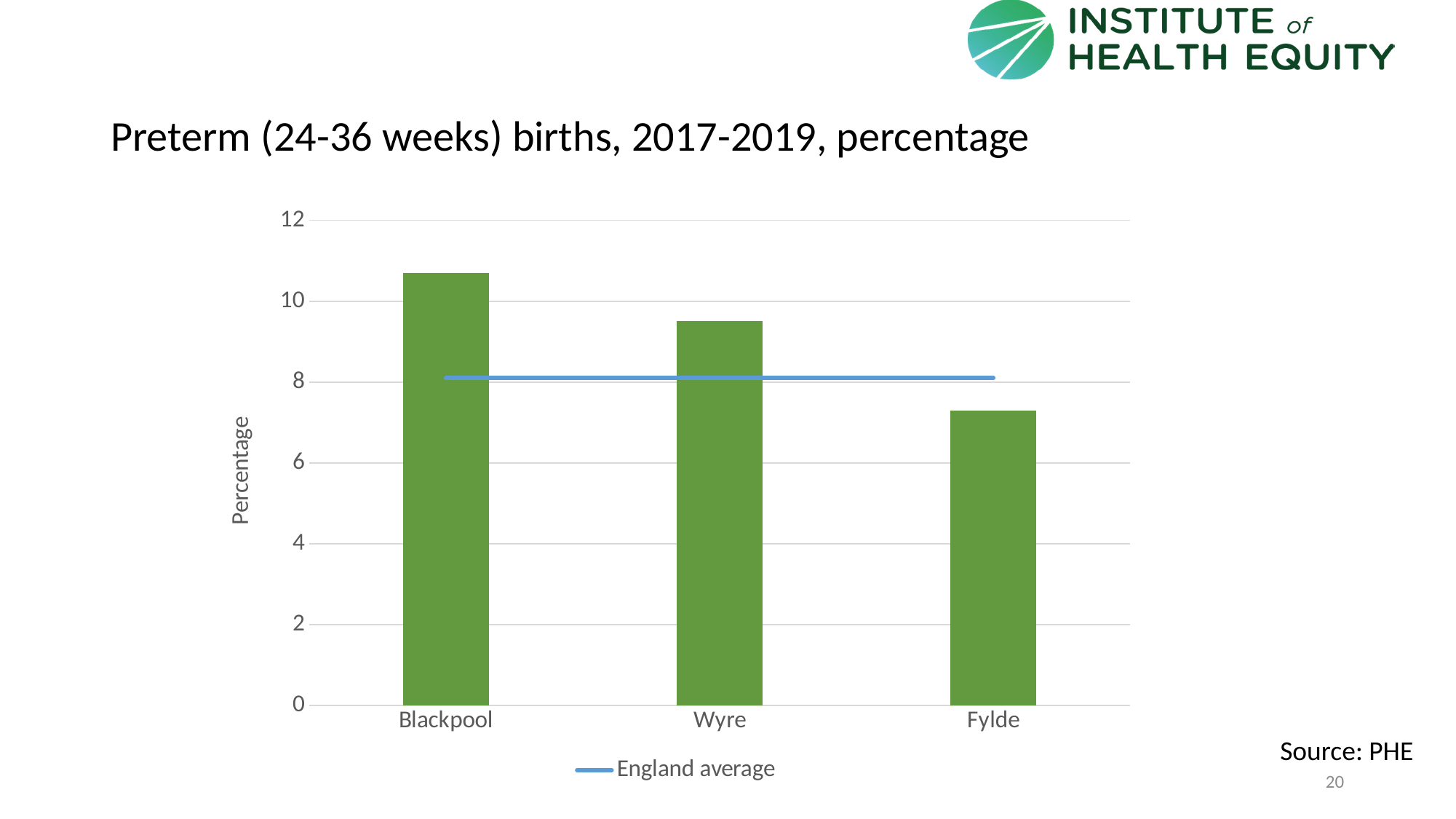
Which has a higher preterm birth percentage, Blackpool or Wyre? Blackpool Is the value for Wyre greater or less than 10? less Which area has the highest preterm birth percentage? Blackpool What kind of chart is shown on the slide? bar chart Is the value for Fylde greater or less than 8? less What is the title of the chart? Preterm (24-36 weeks) births, 2017-2019, percentage How many areas (bars) are plotted on the chart? 3 Which area has the lowest preterm birth percentage? Fylde Do the bar values rise or fall from Blackpool to Fylde along the x axis? fall Which has a higher preterm birth percentage, Wyre or Fylde? Wyre Is the value for Blackpool greater or less than 10? greater What does the horizontal blue line on the chart represent, according to the legend? England average